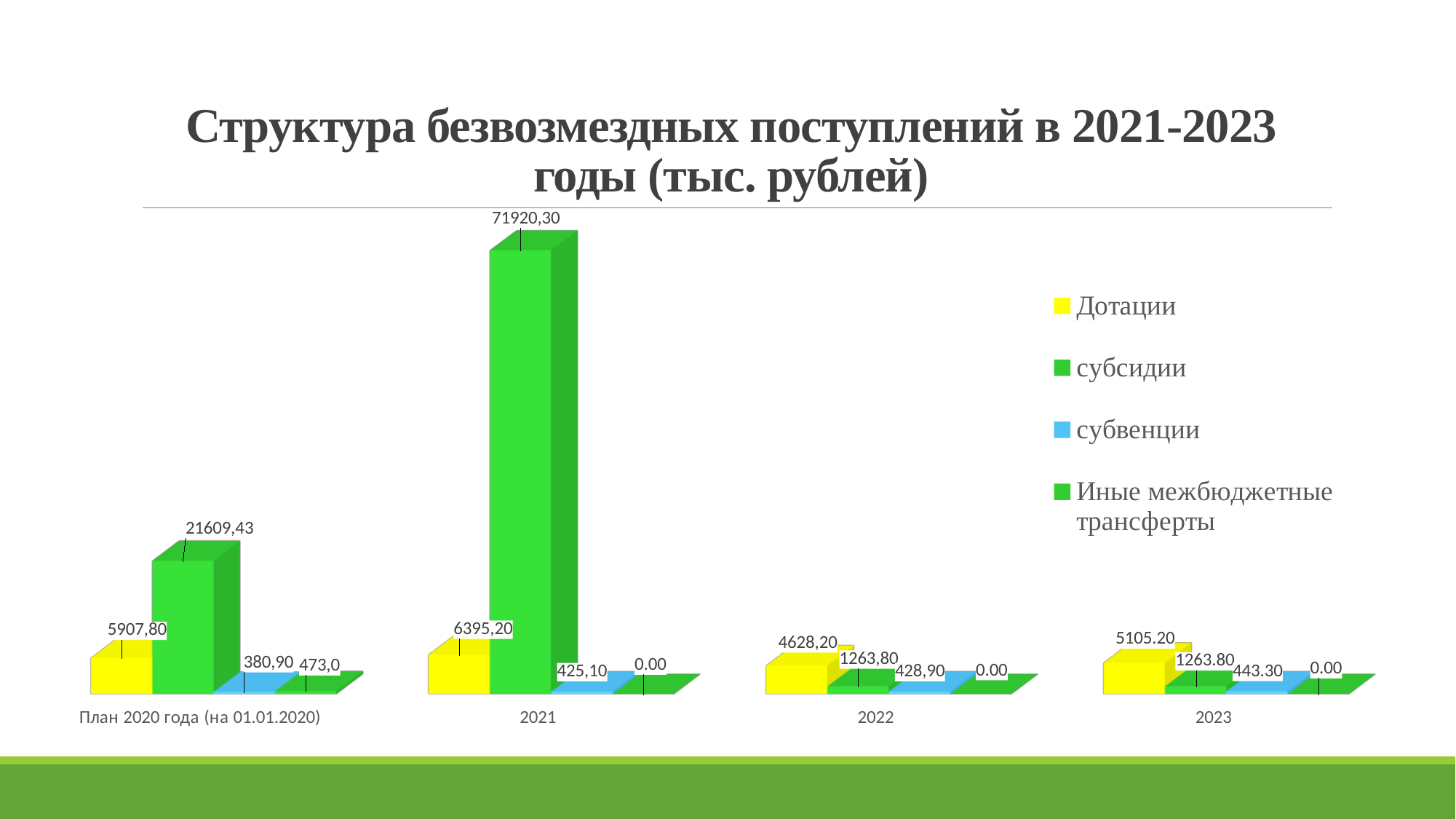
What is the value of Иные межбюджетные трансферты for План 2020 года (на 01.01.2020)? 473,0 What kind of chart is shown on the slide? Bar chart What is the value of субвенции for 2023? 443.30 What is the value of Дотации for План 2020 года (на 01.01.2020)? 5907,80 How many categories are shown on the x axis? 4 In which category is the value of Дотации lowest? 2022 In which year is the value of субсидии highest? 2021 Which is larger: субсидии for План 2020 года (на 01.01.2020) or субсидии for 2022? План 2020 года (на 01.01.2020) What is the difference between Дотации in 2021 and Дотации in 2022? 1767,00 How many series does the legend list? 4 What is the value of субсидии for 2021? 71920,30 Which series is shown in yellow in the legend? Дотации